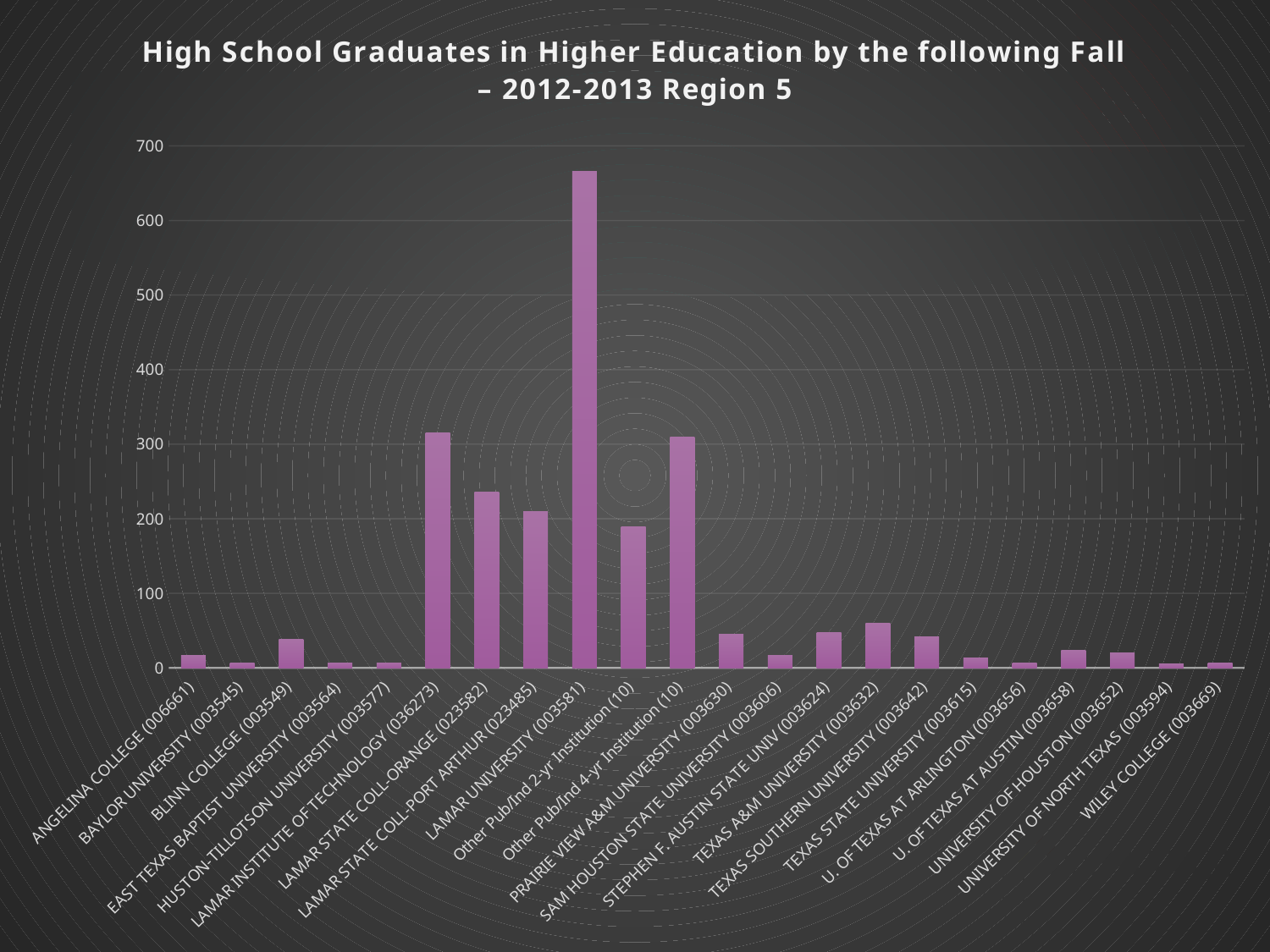
Is the value for LAMAR STATE COLL-ORANGE (023582) greater or less than 200? greater Is the value for LAMAR INSTITUTE OF TECHNOLOGY (036273) greater or less than 300? greater What kind of chart is shown on the slide? Bar chart Which is larger, the value for LAMAR INSTITUTE OF TECHNOLOGY (036273) or LAMAR STATE COLL-ORANGE (023582)? LAMAR INSTITUTE OF TECHNOLOGY (036273) Which institution has the highest bar? LAMAR UNIVERSITY (003581) What colour are the bars in the chart? Purple What is the title of the chart? High School Graduates in Higher Education by the following Fall – 2012-2013 Region 5 Is the value for TEXAS A&M UNIVERSITY (003632) greater or less than 100? less How many institutions (categories) are shown on the x axis? 22 Which is larger, the value for LAMAR UNIVERSITY (003581) or Other Pub/Ind 4-yr Institution (10)? LAMAR UNIVERSITY (003581)